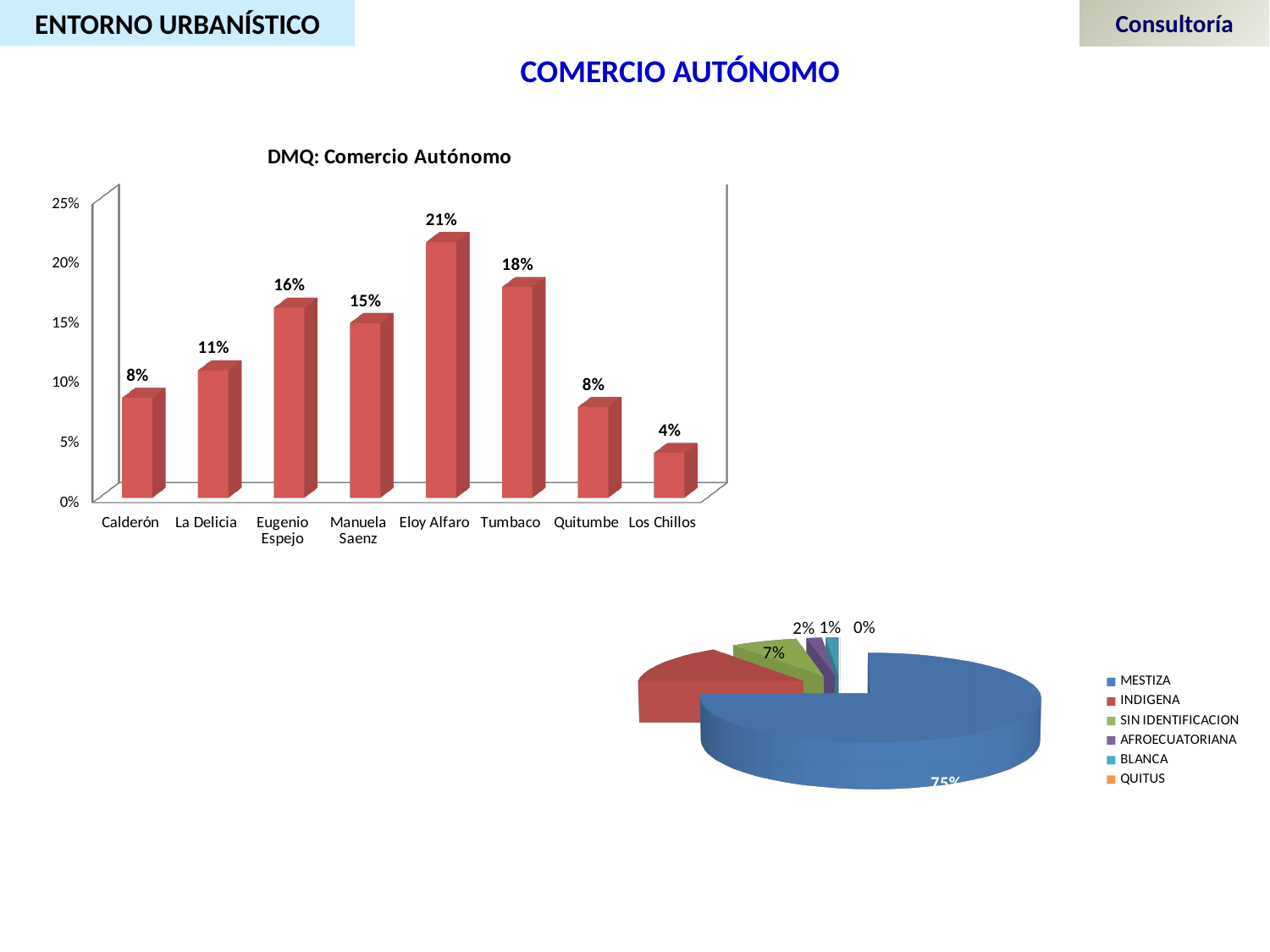
What kind of chart is the chart at the bottom right of the slide? Pie chart In the pie chart at the bottom right of the slide, which category has the largest slice? MESTIZA In the bar chart 'DMQ: Comercio Autónomo', which category has the highest value? Eloy Alfaro In the bar chart 'DMQ: Comercio Autónomo', which category has the lowest value? Los Chillos In the bar chart 'DMQ: Comercio Autónomo', which is larger, the value for Eugenio Espejo or the value for Manuela Saenz? Eugenio Espejo How many categories are shown in the bar chart 'DMQ: Comercio Autónomo'? 8 In the bar chart 'DMQ: Comercio Autónomo', what is the difference between the values for Eloy Alfaro and Los Chillos? 17% In the bar chart 'DMQ: Comercio Autónomo', what is the value for Tumbaco? 18% What kind of chart is the chart titled 'DMQ: Comercio Autónomo'? Bar chart In the bar chart 'DMQ: Comercio Autónomo', what is the value for La Delicia? 11% In the bar chart 'DMQ: Comercio Autónomo', what is the value for Eloy Alfaro? 21% How many entries does the legend of the pie chart at the bottom right of the slide list? 6